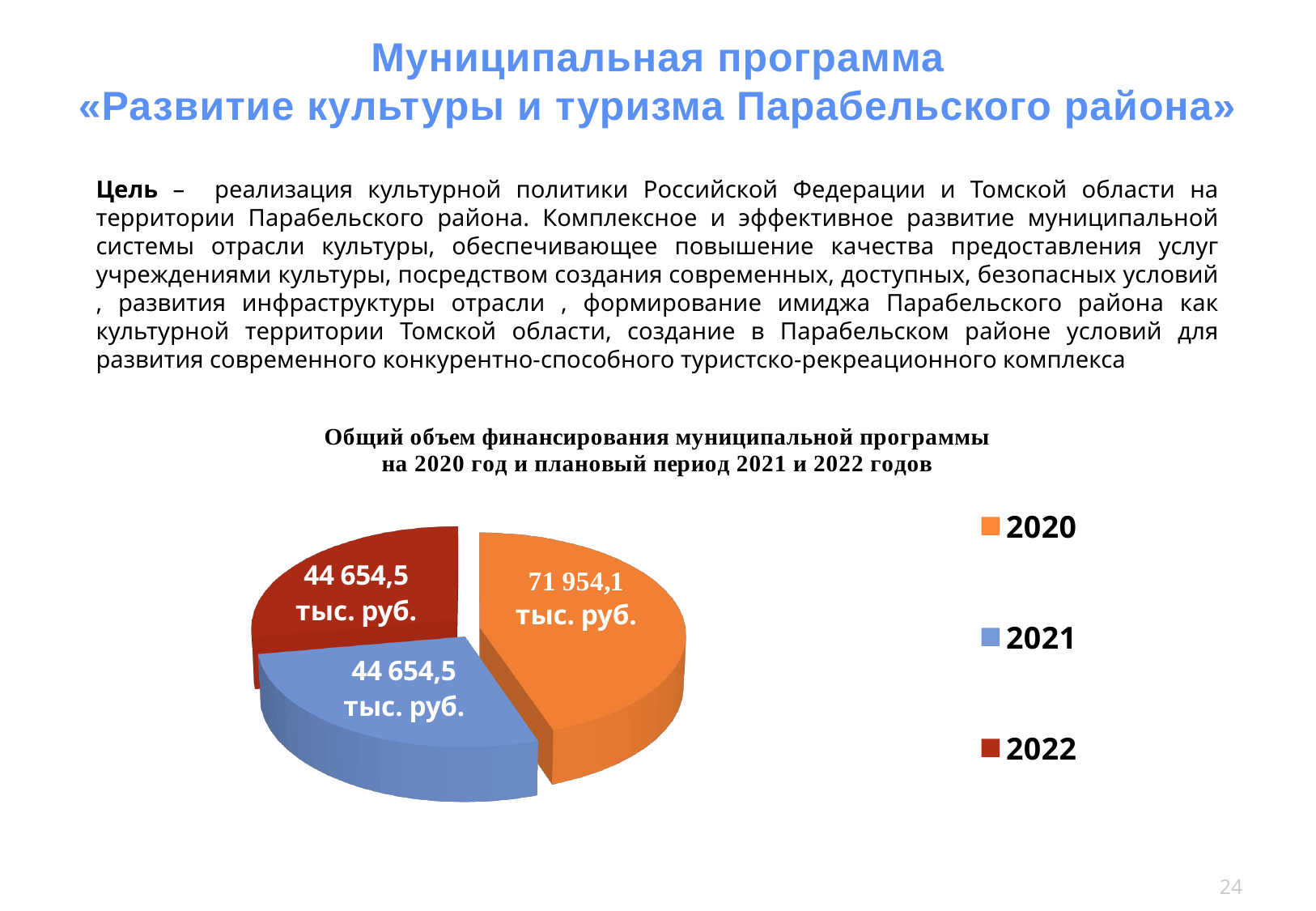
How many slices does the pie chart have? 3 What is the value shown for 2021 on the pie chart? 44 654,5 тыс. руб. What is the value shown for 2022 on the pie chart? 44 654,5 тыс. руб. What colour is the slice for 2020 in the pie chart? Orange What is the difference between the values for 2020 and 2021? 27 299,6 тыс. руб. What is the title of the chart? Общий объем финансирования муниципальной программы на 2020 год и плановый период 2021 и 2022 годов Which is larger, the value for 2020 or the value for 2021? 2020 What is the total of all three slices of the pie chart? 161 263,1 тыс. руб. What is the value shown for 2020 on the pie chart? 71 954,1 тыс. руб. How many entries does the chart legend list? 3 Which year has the largest slice of the pie chart? 2020 What kind of chart is shown on the slide? Pie chart